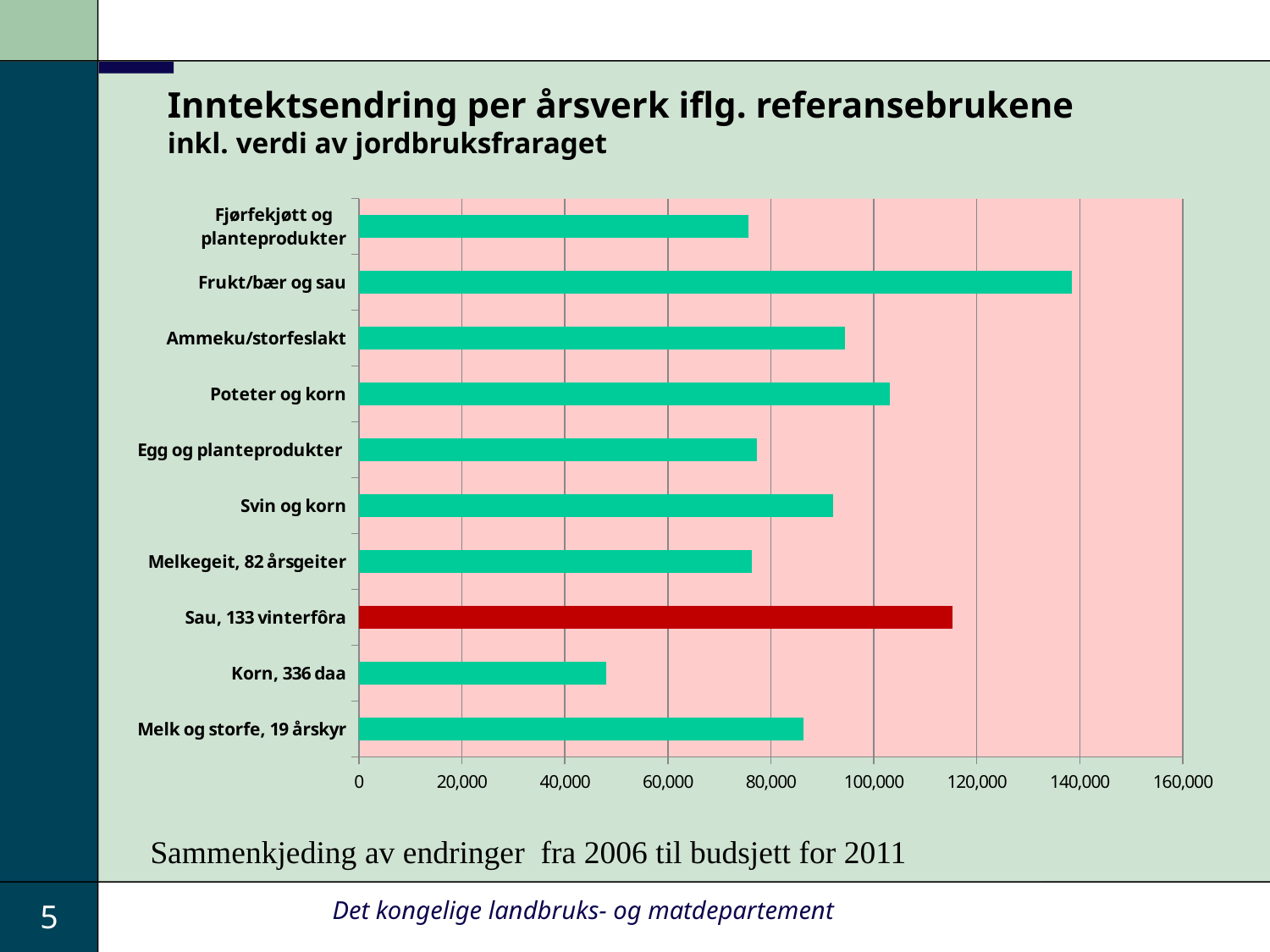
Is the value for Poteter og korn greater or less than 100,000? greater What is the main title of the chart on the slide? Inntektsendring per årsverk iflg. referansebrukene Is the value for Frukt/bær og sau greater or less than 120,000? greater Which is larger, the value for Sau, 133 vinterfôra or the value for Melk og storfe, 19 årskyr? Sau, 133 vinterfôra Is the value for Sau, 133 vinterfôra greater or less than 100,000? greater Which category has the lowest value in the chart? Korn, 336 daa Which is larger, the value for Ammeku/storfeslakt or the value for Korn, 336 daa? Ammeku/storfeslakt Which category has the highest value in the chart? Frukt/bær og sau How many categories are plotted in the chart? 10 What kind of chart is shown on the slide? bar chart Which category's bar is coloured red instead of green? Sau, 133 vinterfôra